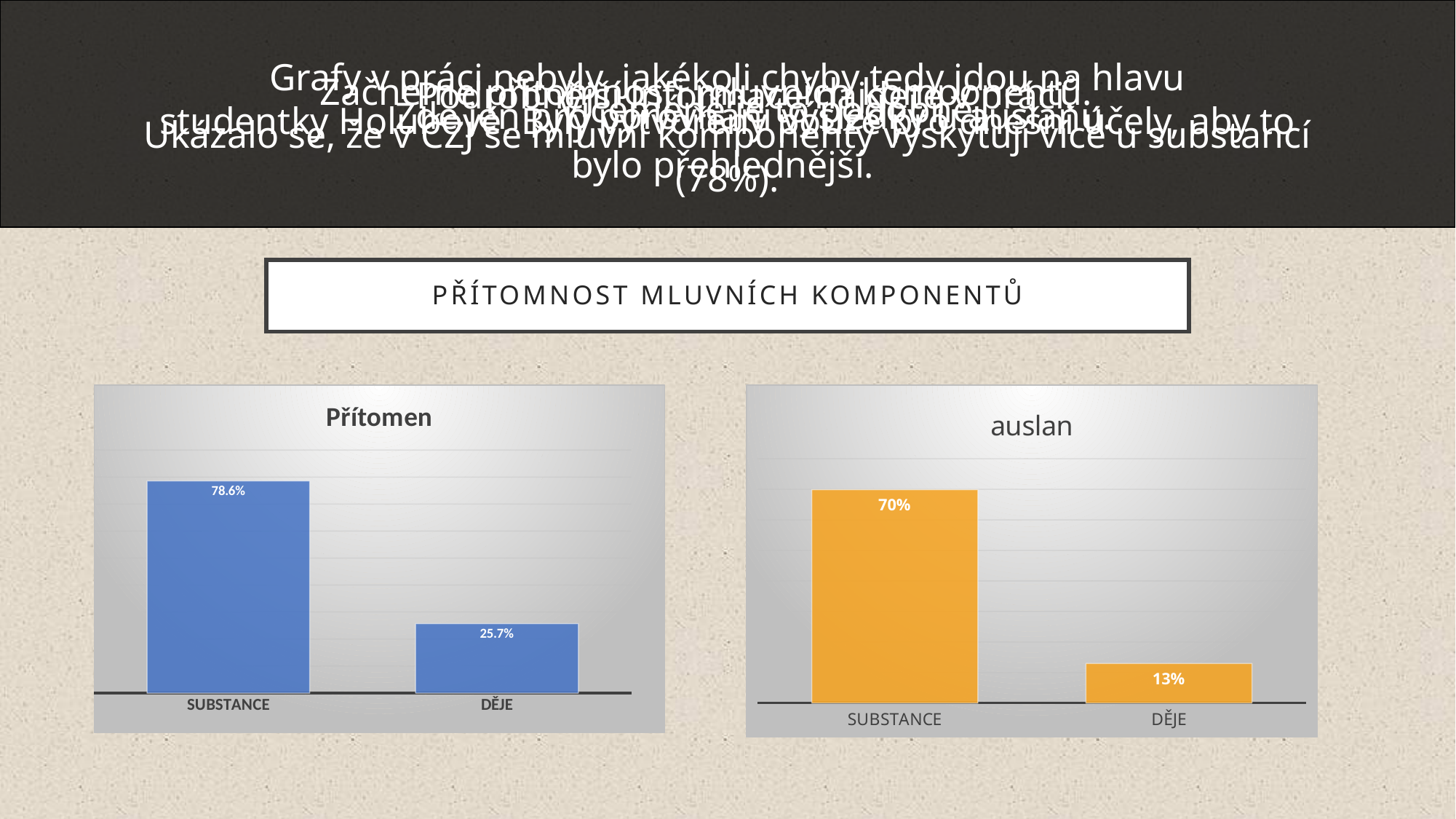
In the chart titled "auslan", what is the value for SUBSTANCE? 70% In the chart titled "auslan", which category has the lowest value? DĚJE In the chart titled "Přítomen", what is the value for SUBSTANCE? 78.6% In the chart titled "auslan", what is the value for DĚJE? 13% In the chart titled "auslan", what is the difference between the values for SUBSTANCE and DĚJE? 57% In the chart titled "Přítomen", which category has the highest value? SUBSTANCE What colour are the bars in the chart titled "auslan"? Orange In the chart titled "Přítomen", what is the difference between the values for SUBSTANCE and DĚJE? 52.9% In the chart titled "Přítomen", what is the value for DĚJE? 25.7% What kind of chart is the chart titled "Přítomen"? Bar chart Which is larger: the SUBSTANCE value in the "Přítomen" chart or the SUBSTANCE value in the "auslan" chart? Přítomen (78.6%) How many categories are shown in the chart titled "auslan"? 2